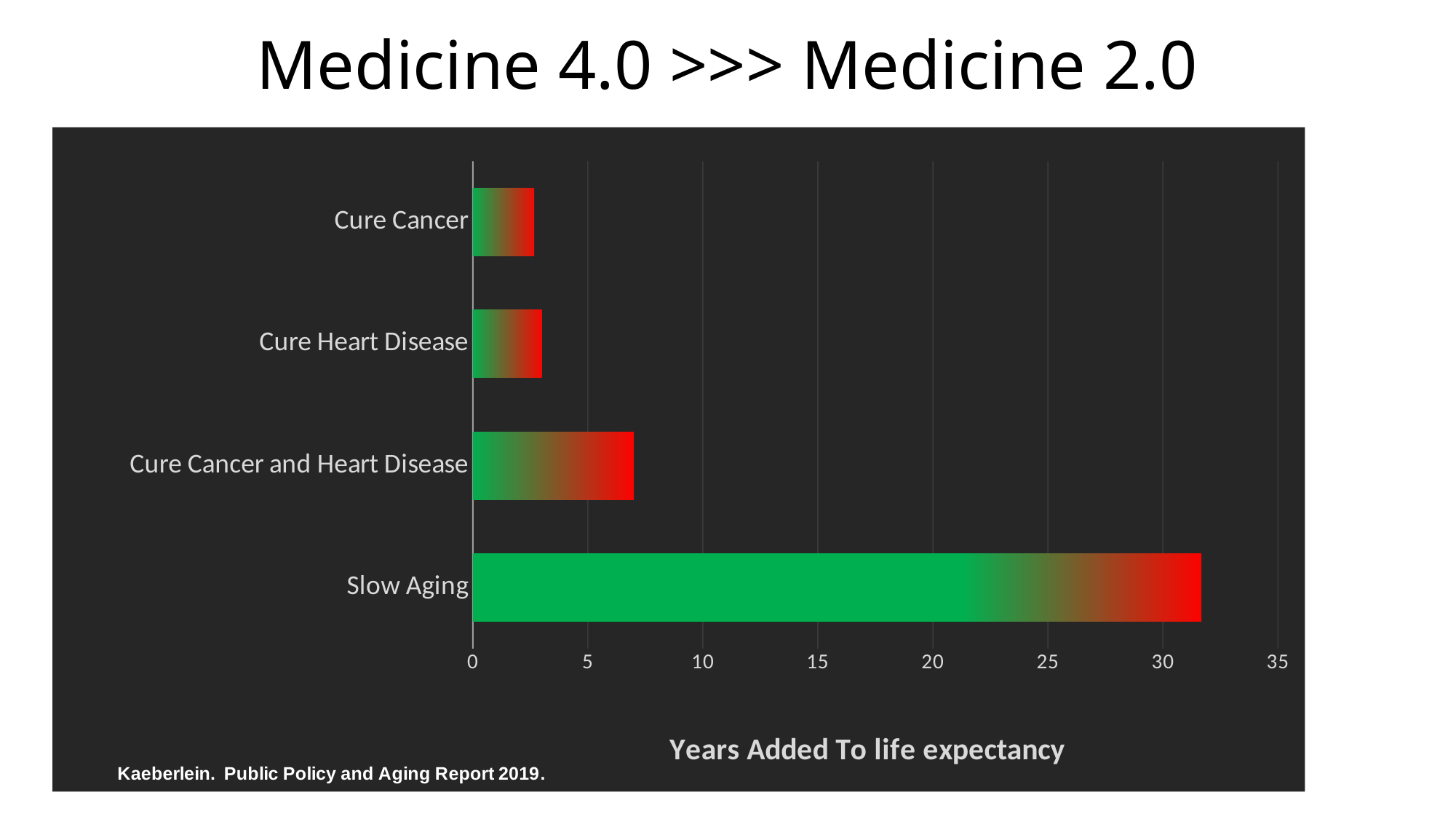
What is the title of the slide containing the chart? Medicine 4.0 >>> Medicine 2.0 Which is larger, the value for Cure Cancer and Heart Disease or the value for Cure Cancer? Cure Cancer and Heart Disease Which category has the highest value for years added to life expectancy? Slow Aging How many categories are plotted in the chart? 4 Is the value for Cure Cancer and Heart Disease greater or less than 5? greater Is the value for Cure Cancer and Heart Disease greater or less than 10? less Is the value for Cure Heart Disease greater or less than 5? less What is the label of the horizontal axis of the chart? Years Added To life expectancy Which is larger, the value for Slow Aging or the value for Cure Cancer and Heart Disease? Slow Aging What kind of chart is shown on the slide? bar chart